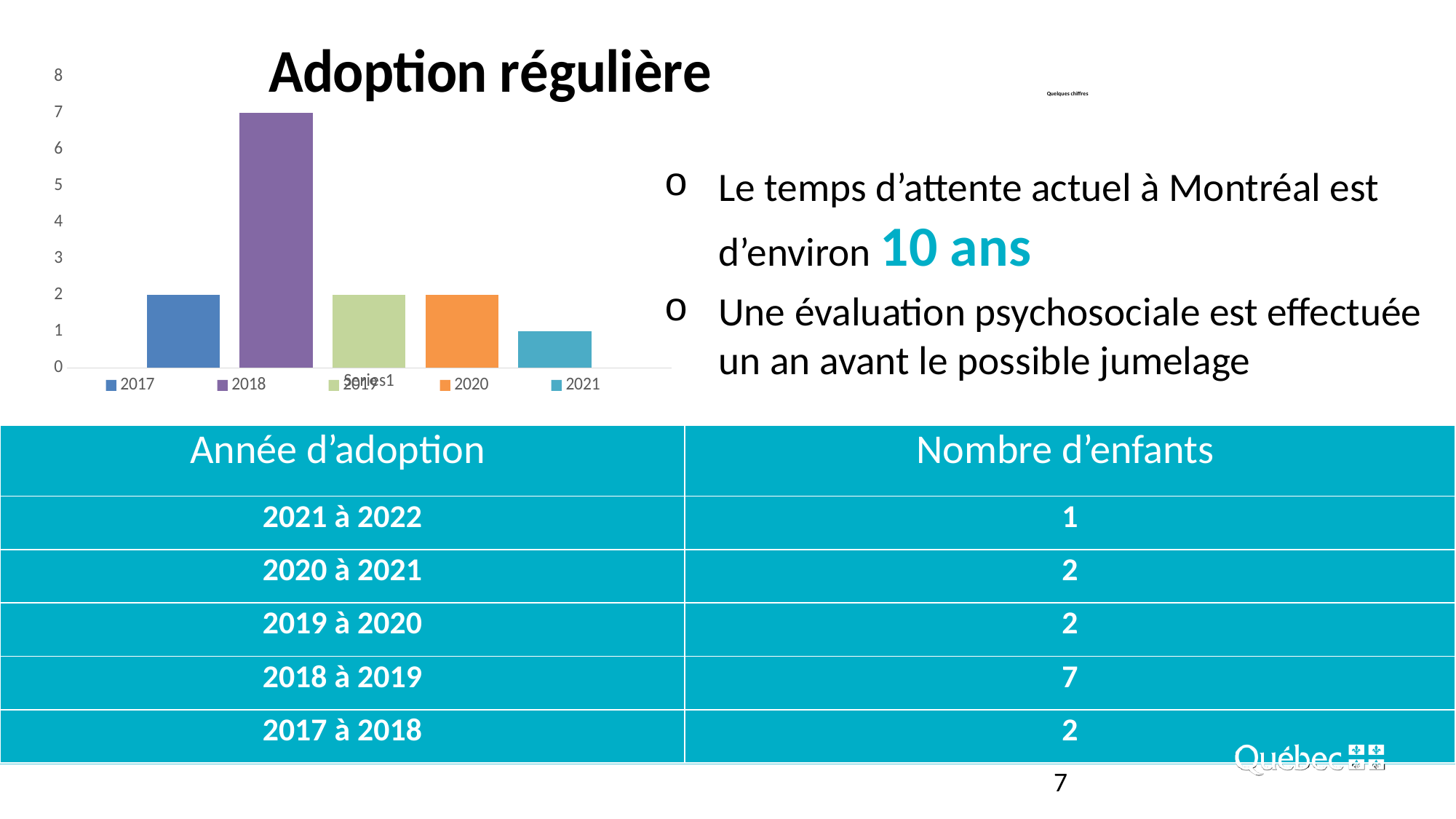
Which year has the lowest bar in the chart? 2021 What is the value of the 2021 bar in the chart? 1 What is the value of the 2017 bar in the chart? 2 What is the title shown above the chart? Adoption régulière How many series does the chart legend list? 5 What colour is the 2018 bar in the chart? purple Is the value for 2018 greater or less than 5? greater What is the difference between the 2018 bar and the 2021 bar? 6 Which year has the highest bar in the chart? 2018 What kind of chart is shown on the slide? bar chart Which is larger in the chart, the 2018 bar or the 2020 bar? 2018 What is the value of the 2018 bar in the chart? 7